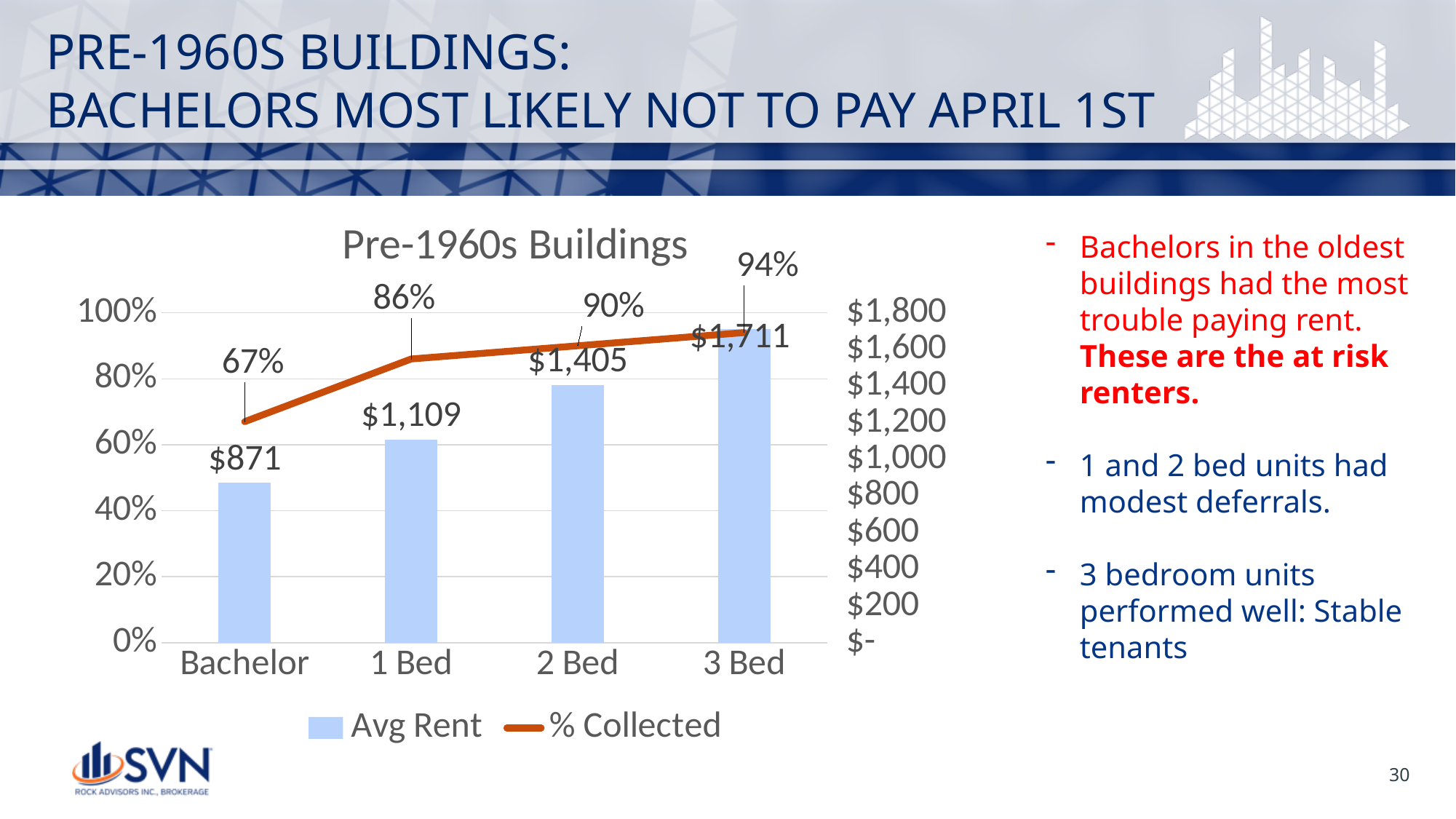
What is the average rent for Bachelor units? $871 How many unit types are shown on the x axis? 4 Which unit type has the lowest % Collected? Bachelor What is the average rent for 3 Bed units? $1,711 What is the title of the chart? Pre-1960s Buildings What is the difference in average rent between 2 Bed and 1 Bed units? $296 How many series does the legend list? 2 Which unit type has the highest average rent? 3 Bed Which has a higher % Collected, 1 Bed or 2 Bed? 2 Bed Does the % Collected rise or fall from Bachelor to 3 Bed? Rise What is the difference in % Collected between 3 Bed and Bachelor units? 27% What percentage of rent was collected for 2 Bed units? 90%